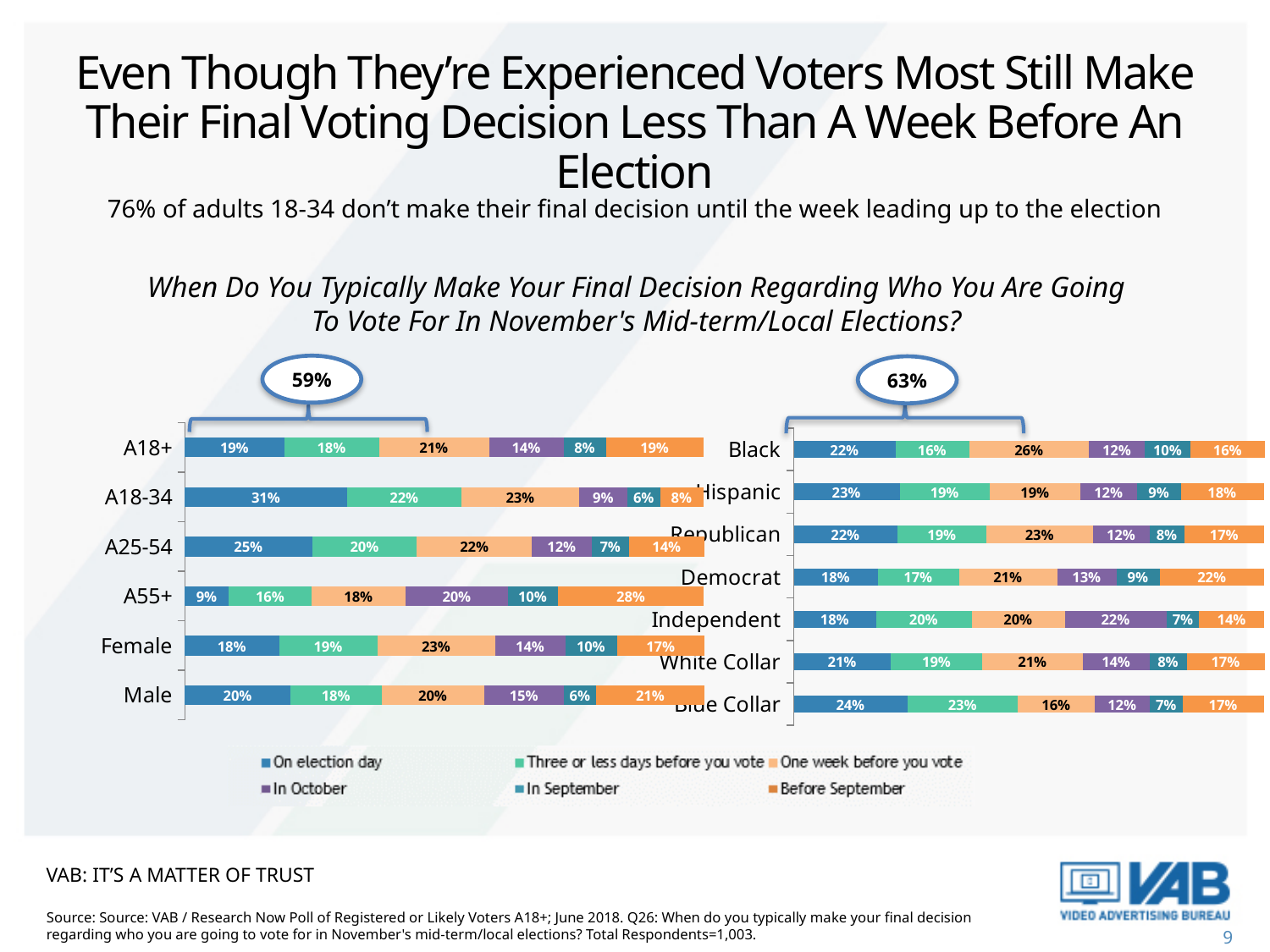
In the left chart, which category has the lowest 'On election day' value? A55+ In the left chart, what percentage of A55+ respondents make their final decision before September? 28% In the left chart, what percentage of A18-34 respondents make their final decision on election day? 31% In the left chart, which category has the highest 'On election day' value? A18-34 What kind of chart is used on this slide? Stacked bar chart How many series does the legend list? 6 In the right chart, which category has the highest 'On election day' value? Blue Collar In the right chart, what percentage of Black respondents make their final decision one week before they vote? 26% In the right chart, which is larger: the 'Before September' value for Democrat or for Independent? Democrat In the right chart, what percentage of Independent respondents make their final decision in October? 22% In the left chart, what is the difference between the 'On election day' values for A18-34 and A55+? 22% How many categories are shown in the right chart? 7